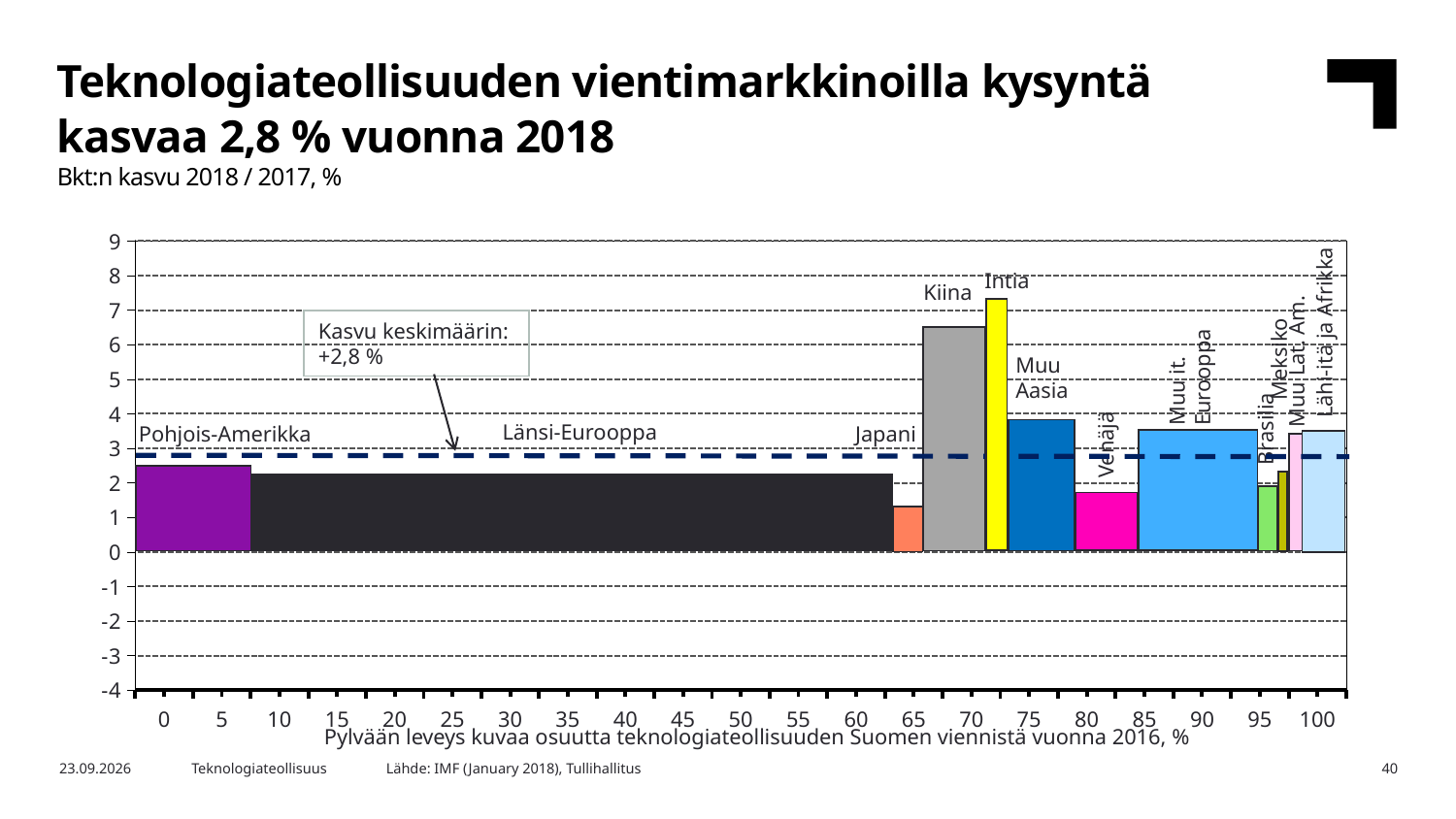
Is the value for Intia greater or less than 6? greater What average growth value does the dashed horizontal line represent, according to the annotation? +2,8 % Is the value for Muu Aasia greater or less than 3? greater Is the value for Kiina greater or less than 5? greater What kind of chart is shown on the slide? bar chart Which region has the lowest GDP growth in the chart? Japani How many regions are shown as bars in the chart? 12 Which region has the highest GDP growth in the chart? Intia Which has the higher GDP growth, Intia or Kiina? Intia Which has the higher GDP growth, Kiina or Japani? Kiina